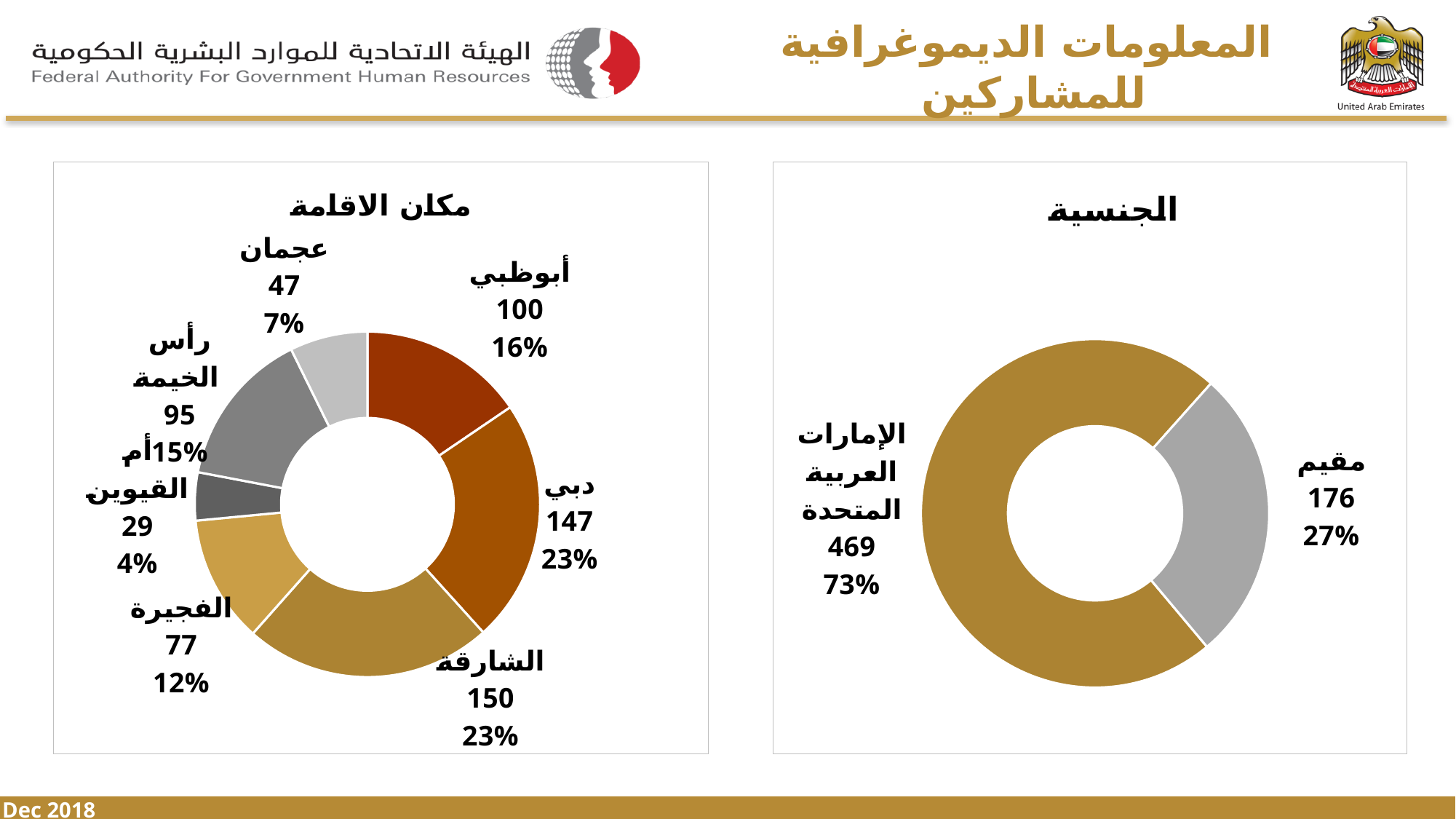
What kind of chart is the chart titled الجنسية? Doughnut chart In the chart titled الجنسية, what percentage share does الإمارات العربية المتحدة have? 73% In the chart titled مكان الاقامة, which category has the lowest value? أم القيوين In the chart titled مكان الاقامة, which is larger, the value for رأس الخيمة or the value for الفجيرة? رأس الخيمة In the chart titled مكان الاقامة, which category has the highest value? الشارقة In the chart titled مكان الاقامة, what is the value for دبي? 147 In the chart titled مكان الاقامة, how many categories are shown? 7 What is the title of the chart on the left side of the slide? مكان الاقامة In the chart titled مكان الاقامة, what is the difference between the values for أبوظبي and عجمان? 53 In the chart titled مكان الاقامة, what percentage share does الفجيرة have? 12% In the chart titled الجنسية, what is the value for مقيم? 176 In the chart titled الجنسية, what is the difference between the values for الإمارات العربية المتحدة and مقيم? 293